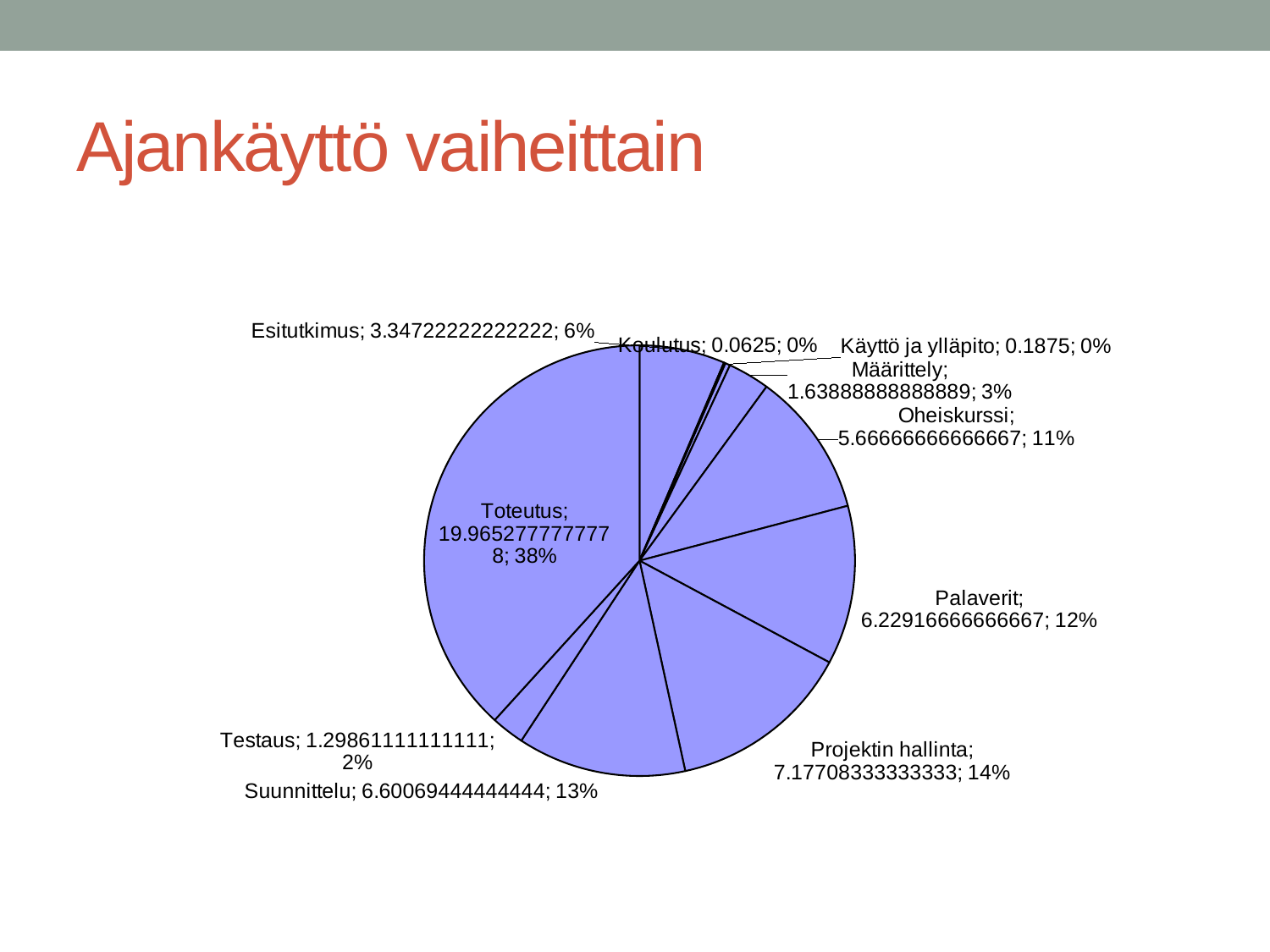
What value is shown for Koulutus? 0.0625 What kind of chart is shown on the slide? pie chart What percentage share does Oheiskurssi have? 11% How many slices does the pie chart have? 10 What value is shown for Palaverit? 6.22916666666667 What is the title of the chart on the slide? Ajankäyttö vaiheittain Which category has the largest share of the pie? Toteutus What percentage share does Projektin hallinta have? 14% What percentage share does Toteutus have? 38% Which category has the smallest share of the pie? Koulutus Which has a larger share, Suunnittelu or Esitutkimus? Suunnittelu What is the difference in percentage share between Toteutus and Projektin hallinta? 24%